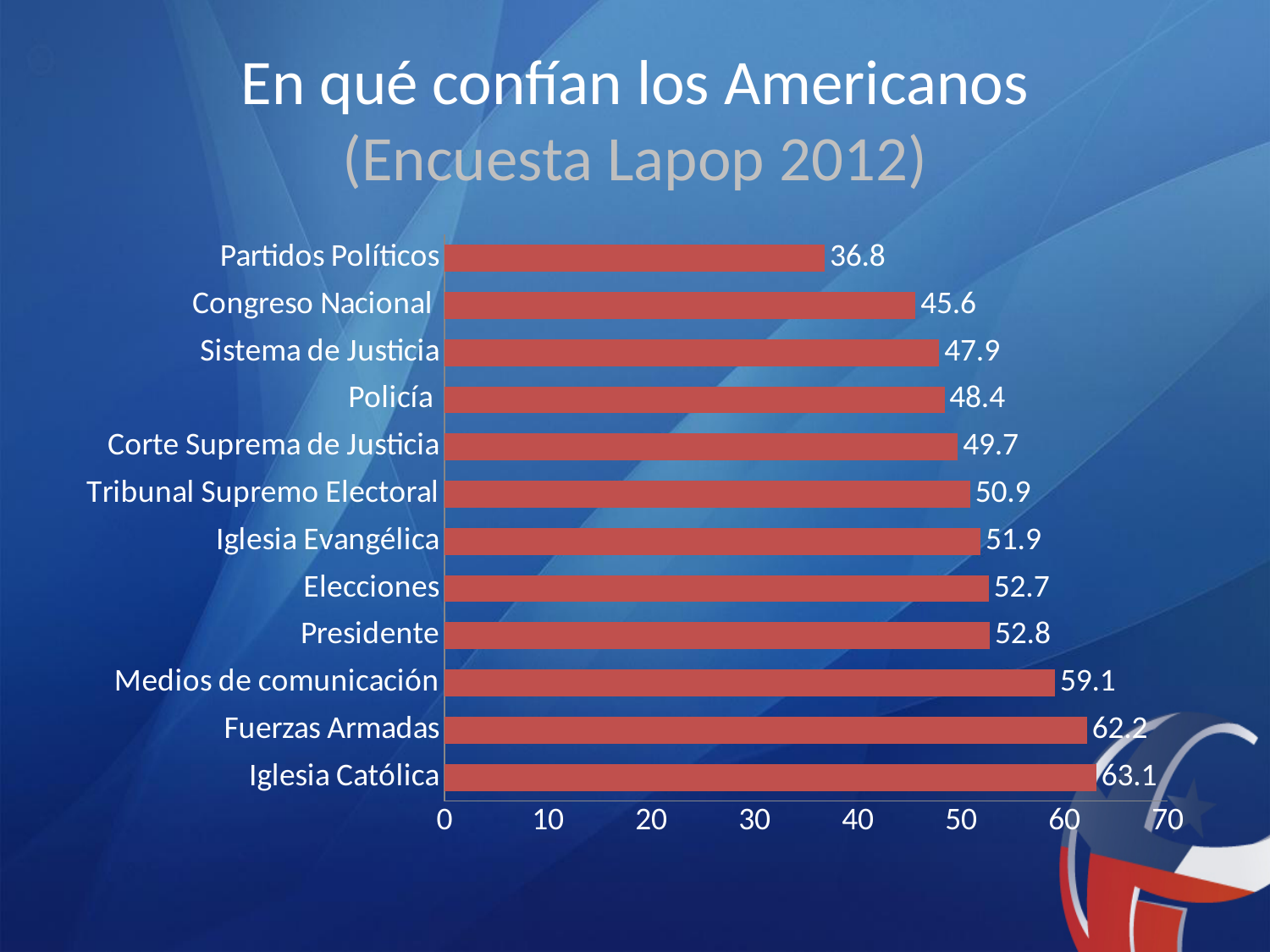
What is the value for Iglesia Católica? 63.1 Which category has the lowest value? Partidos Políticos What is the value for Medios de comunicación? 59.1 Is the value for Elecciones greater or less than 50? greater Which category has the highest value? Iglesia Católica How many categories are shown in the chart? 12 What is the value for Partidos Políticos? 36.8 Which is larger, the value for Policía or the value for Sistema de Justicia? Policía What is the difference between the values for Fuerzas Armadas and Congreso Nacional? 16.6 What kind of chart is shown on the slide? Bar chart What is the title of the slide? En qué confían los Americanos (Encuesta Lapop 2012) What is the value for Tribunal Supremo Electoral? 50.9